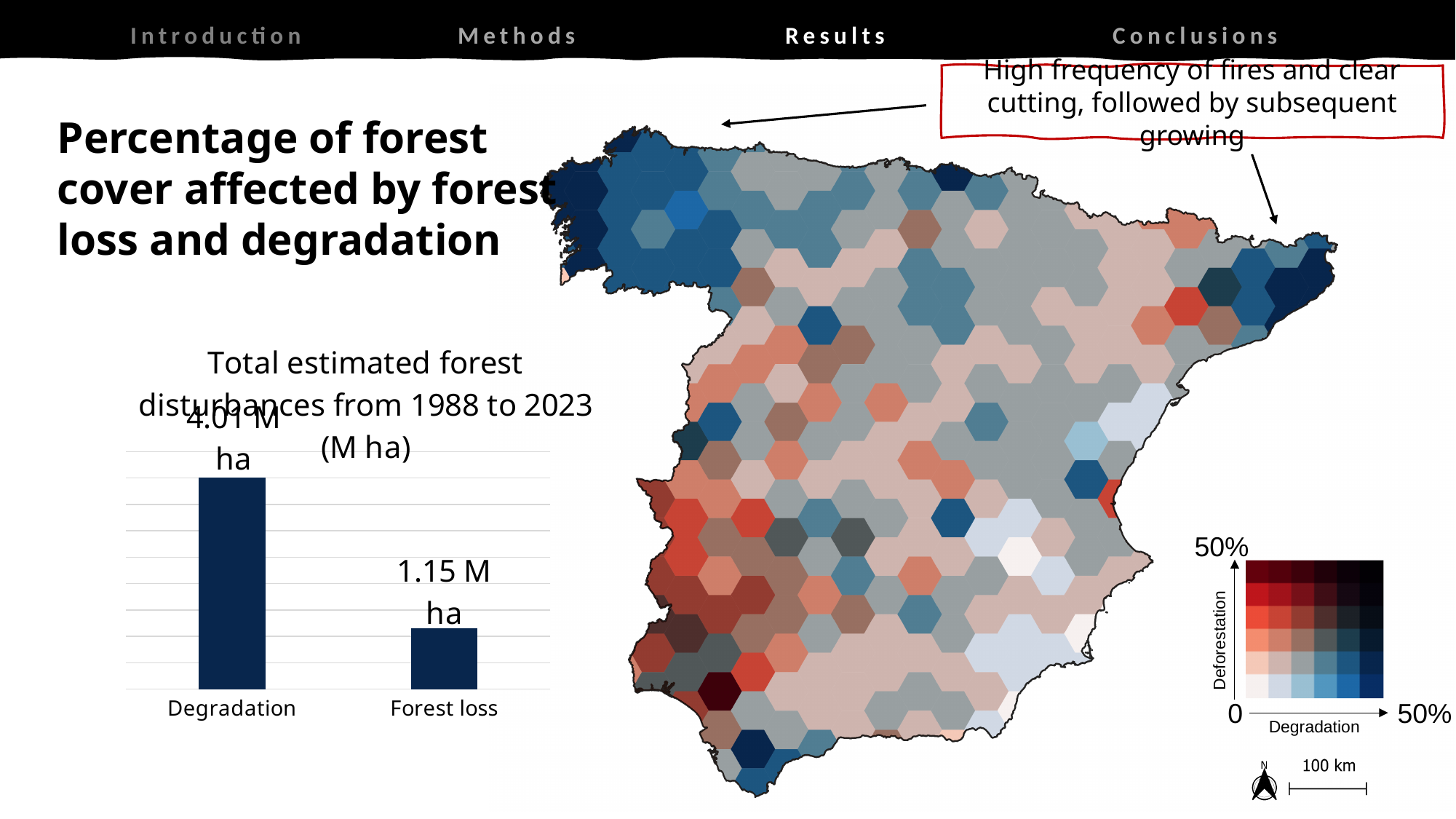
What unit is used for the values in the bar chart? M ha How many categories are shown in the bar chart? 2 What is the value for Forest loss in the bar chart? 1.15 M ha What is the value for Degradation in the bar chart? 4.01 M ha What kind of chart is used to show the total estimated forest disturbances? Bar chart What is the difference between the Degradation and Forest loss values in the bar chart? 2.86 M ha What is the title of the bar chart? Total estimated forest disturbances from 1988 to 2023 (M ha) In the bar chart, which is larger: Degradation or Forest loss? Degradation Which category has the lowest value in the bar chart? Forest loss Which category has the highest value in the bar chart? Degradation